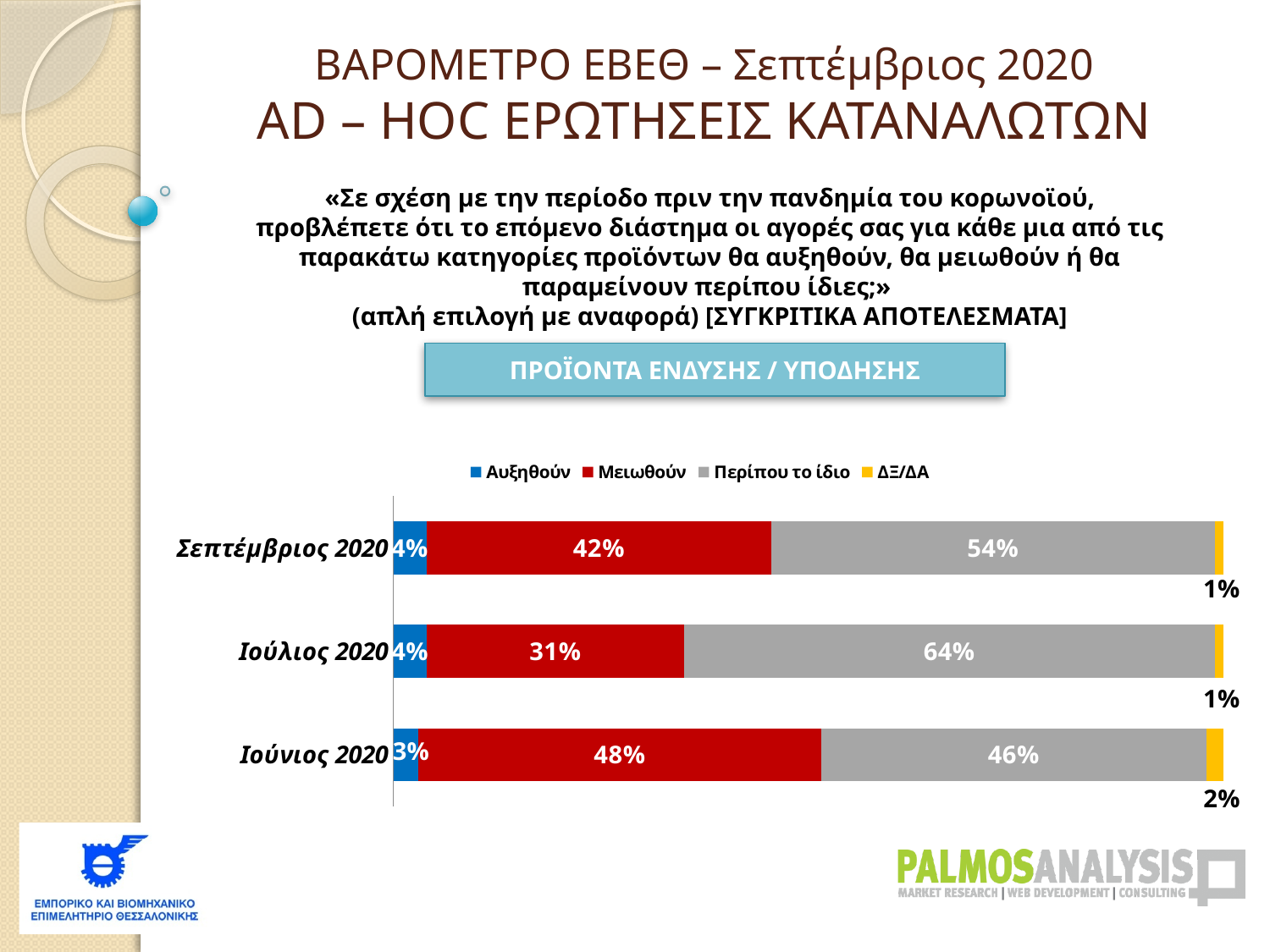
What is the value of Μειωθούν for Σεπτέμβριος 2020? 42% How many series does the legend list? 4 What is the title shown in the box above the chart? ΠΡΟΪΟΝΤΑ ΕΝΔΥΣΗΣ / ΥΠΟΔΗΣΗΣ What is the value of ΔΞ/ΔΑ for Ιούνιος 2020? 2% Which period has the lowest value for Περίπου το ίδιο? Ιούνιος 2020 What is the difference between the Μειωθούν values for Ιούνιος 2020 and Ιούλιος 2020? 17% What is the value of Περίπου το ίδιο for Ιούλιος 2020? 64% What is the value of Αυξηθούν for Ιούνιος 2020? 3% How many categories (time periods) are shown on the chart? 3 Which period has the highest value for Μειωθούν? Ιούνιος 2020 What type of chart is shown on the slide? Stacked bar chart Which is larger for Σεπτέμβριος 2020: Μειωθούν or Περίπου το ίδιο? Περίπου το ίδιο